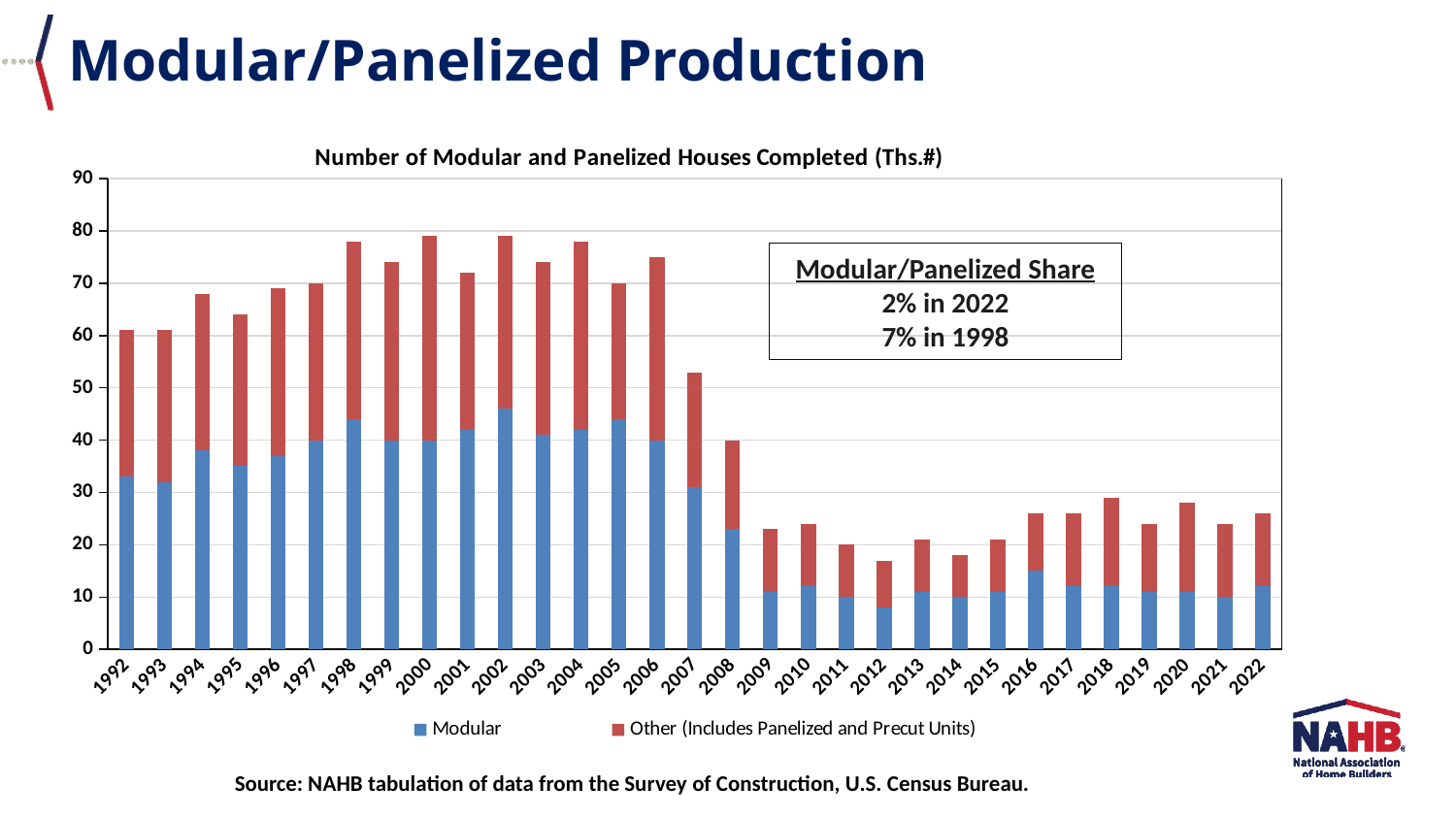
Do the total values rise or fall from 2006 to 2012? fall Is the total value for 2007 greater or less than 50? greater What kind of chart is shown on the slide? Stacked bar chart Which year has the larger total, 1992 or 2022? 1992 How many series does the chart legend list? 2 Is the total value for 2012 greater or less than 20? less How many years are shown along the x axis of the chart? 31 Is the total value for 1998 greater or less than 70? greater What is the title of the chart? Number of Modular and Panelized Houses Completed (Ths.#) Which year has the larger total, 2006 or 2007? 2006